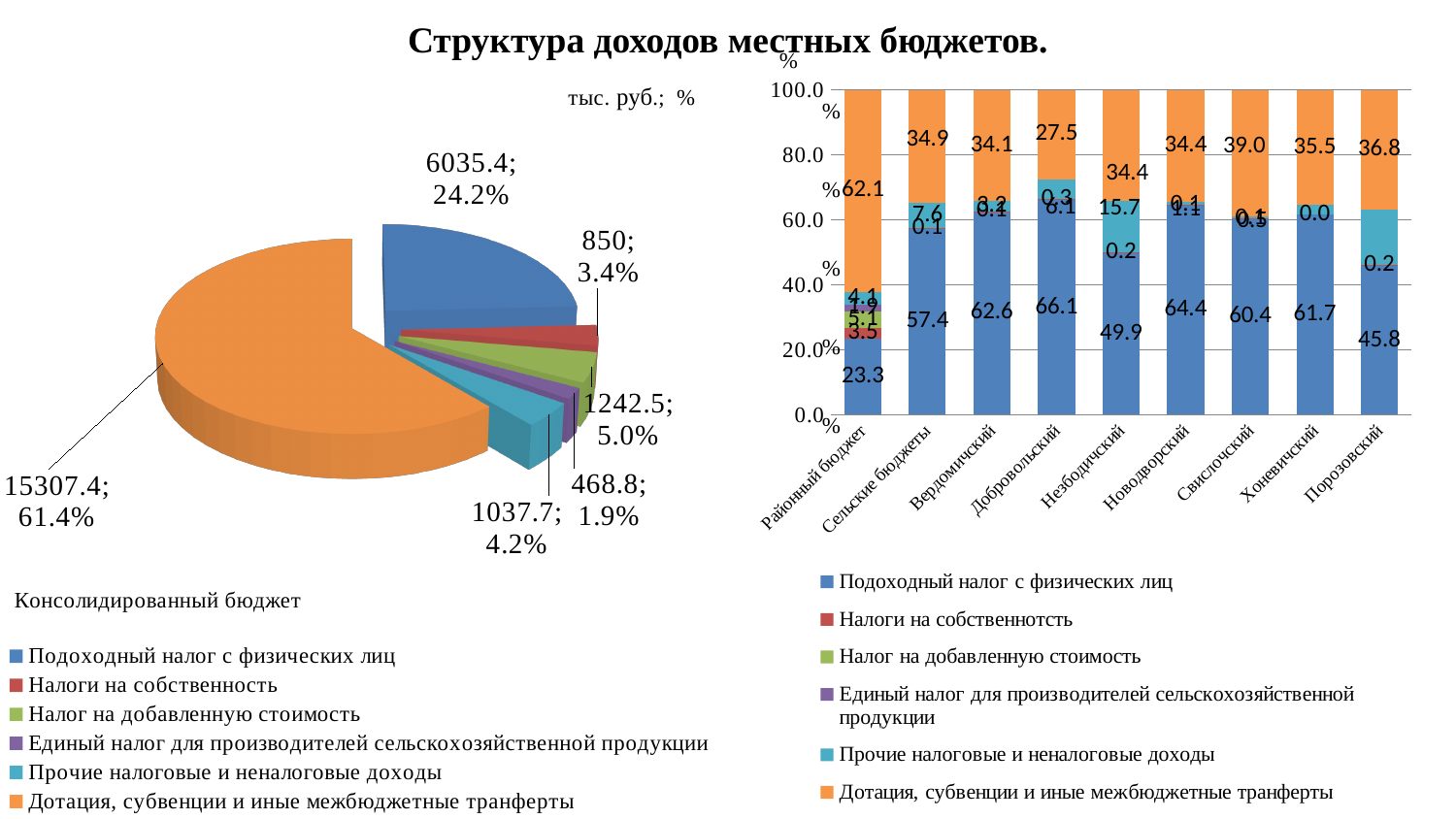
On the pie chart (Консолидированный бюджет), what value is shown for Дотация, субвенции и иные межбюджетные транферты? 15307.4; 61.4% On the stacked bar chart on the right, which is larger: Подоходный налог с физических лиц for Незбодичский or for Новодворский? Новодворский What type of chart is shown on the right side of the slide? Stacked bar chart On the stacked bar chart on the right, how many series does the legend list? 6 On the pie chart (Консолидированный бюджет), what is the difference between the values for Налог на добавленную стоимость and Налоги на собственность? 392.5 On the pie chart (Консолидированный бюджет), what share does Подоходный налог с физических лиц have? 24.2% On the stacked bar chart on the right, how many categories are shown on the x axis? 9 On the stacked bar chart on the right, what is the value of Подоходный налог с физических лиц for Добровольский? 66.1 On the pie chart (Консолидированный бюджет), how many slices are there? 6 On the stacked bar chart on the right, what is the value of Дотация, субвенции и иные межбюджетные транферты for Районный бюджет? 62.1 On the stacked bar chart on the right, which category has the lowest value for Подоходный налог с физических лиц? Районный бюджет On the pie chart (Консолидированный бюджет), which category has the smallest slice? Единый налог для производителей сельскохозяйственной продукции